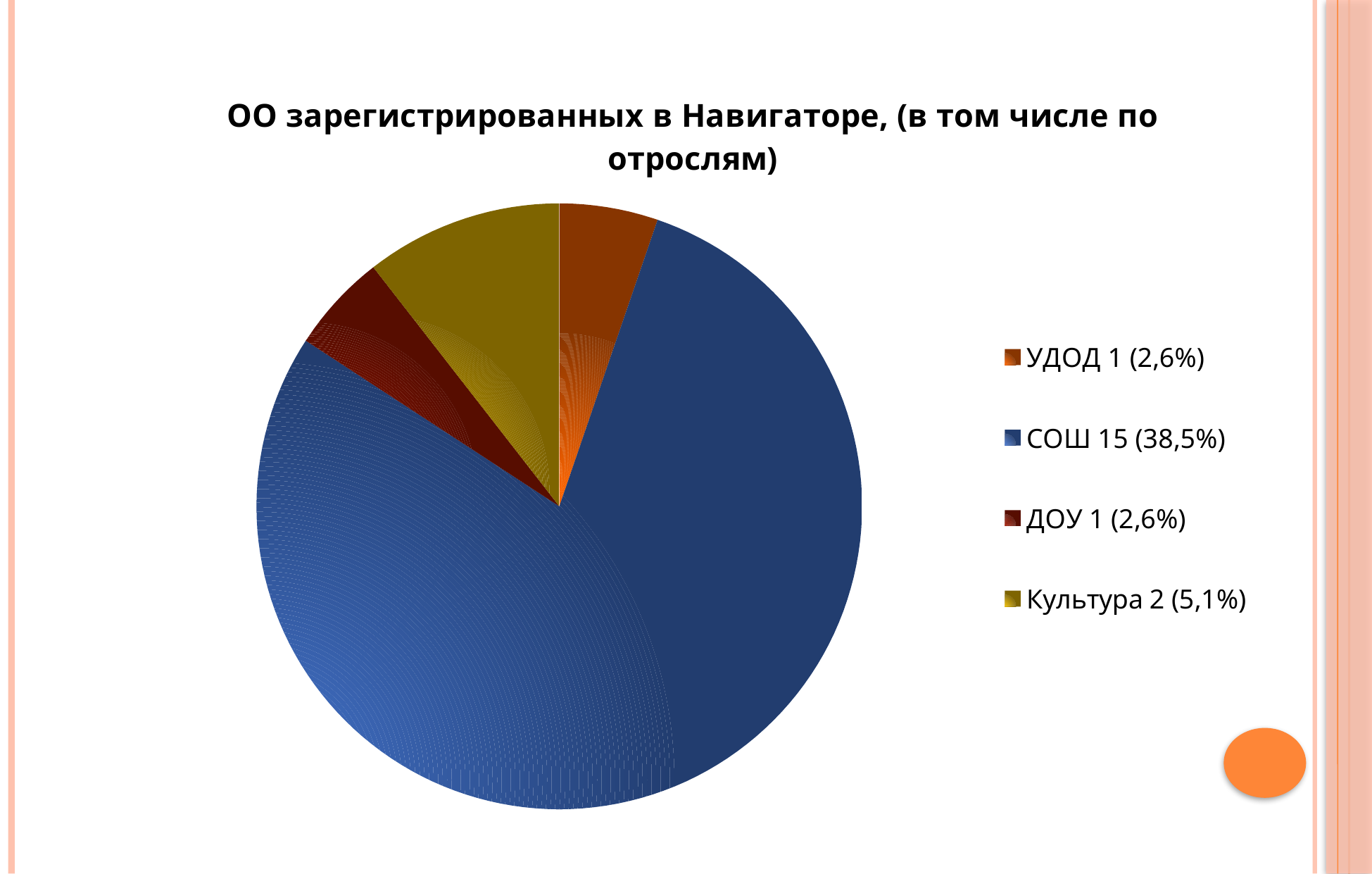
What percentage is shown for СОШ in the legend? 38,5% What percentage is shown for Культура in the legend? 5,1% What is the number shown for СОШ in the legend? 15 What percentage is shown for УДОД in the legend? 2,6% What is the number shown for ДОУ in the legend? 1 Which category has the largest slice of the pie? СОШ How many categories does the pie chart show? 4 What is the number shown for Культура in the legend? 2 What kind of chart is shown on the slide? pie chart What is the difference between the number for СОШ and the number for Культура? 13 Which is larger, the value for Культура or the value for ДОУ? Культура What is the title of the chart? ОО зарегистрированных в Навигаторе, (в том числе по отрослям)